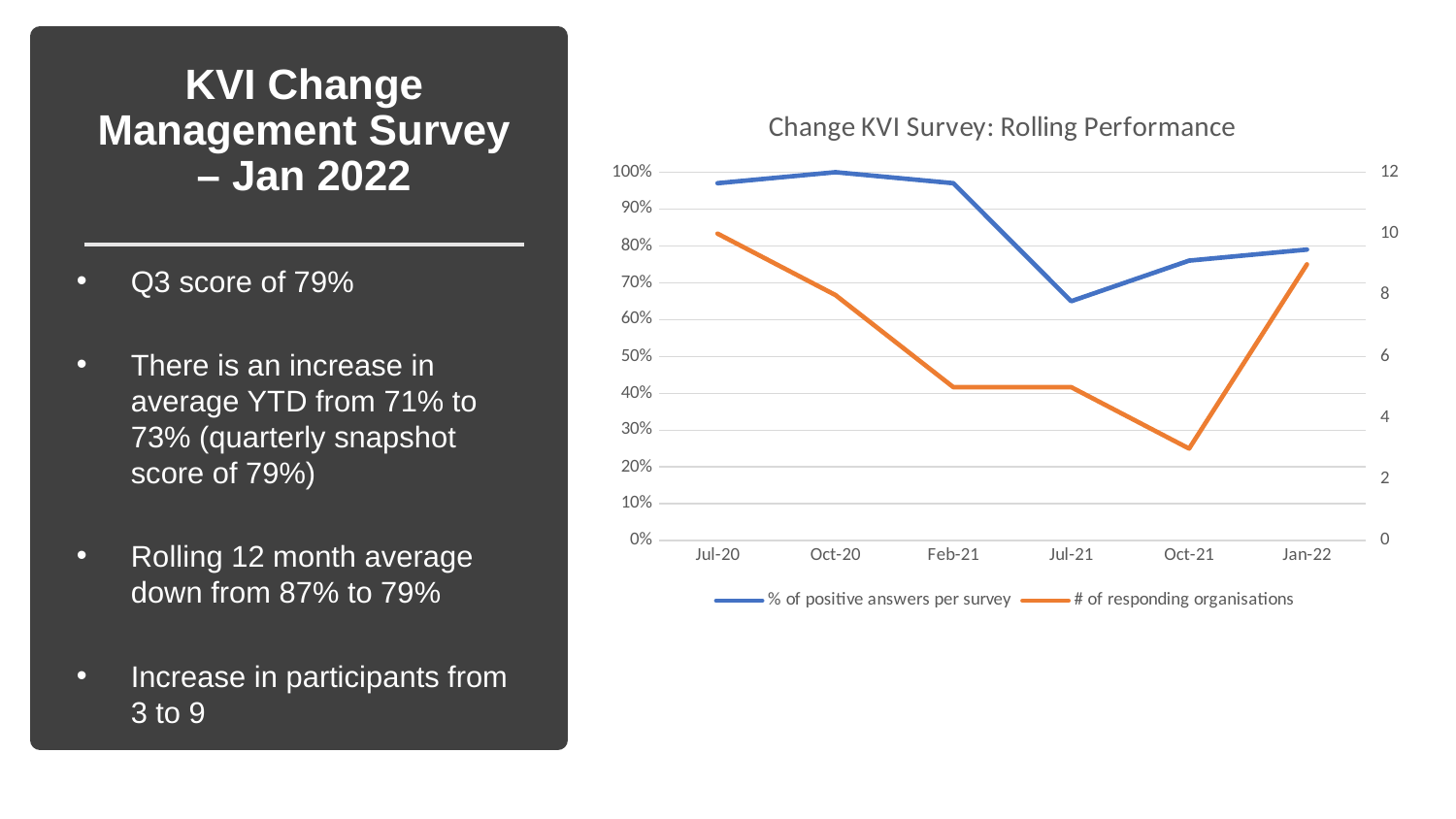
At which date is the % of positive answers per survey highest? Oct-20 How many series does the legend list? 2 Is the % of positive answers per survey at Jan-22 greater or less than 70%? greater At which date is the % of positive answers per survey lowest? Jul-21 Is the # of responding organisations at Oct-21 greater or less than 4? less How many points are plotted along the x axis? 6 Does the # of responding organisations rise or fall from Jul-20 to Oct-21? fall What is the % of positive answers per survey at Oct-20? 100% At which date is the # of responding organisations lowest? Oct-21 What is the title of the chart? Change KVI Survey: Rolling Performance What kind of chart is shown on the slide? line chart Is the % of positive answers per survey at Jul-21 greater or less than 70%? less